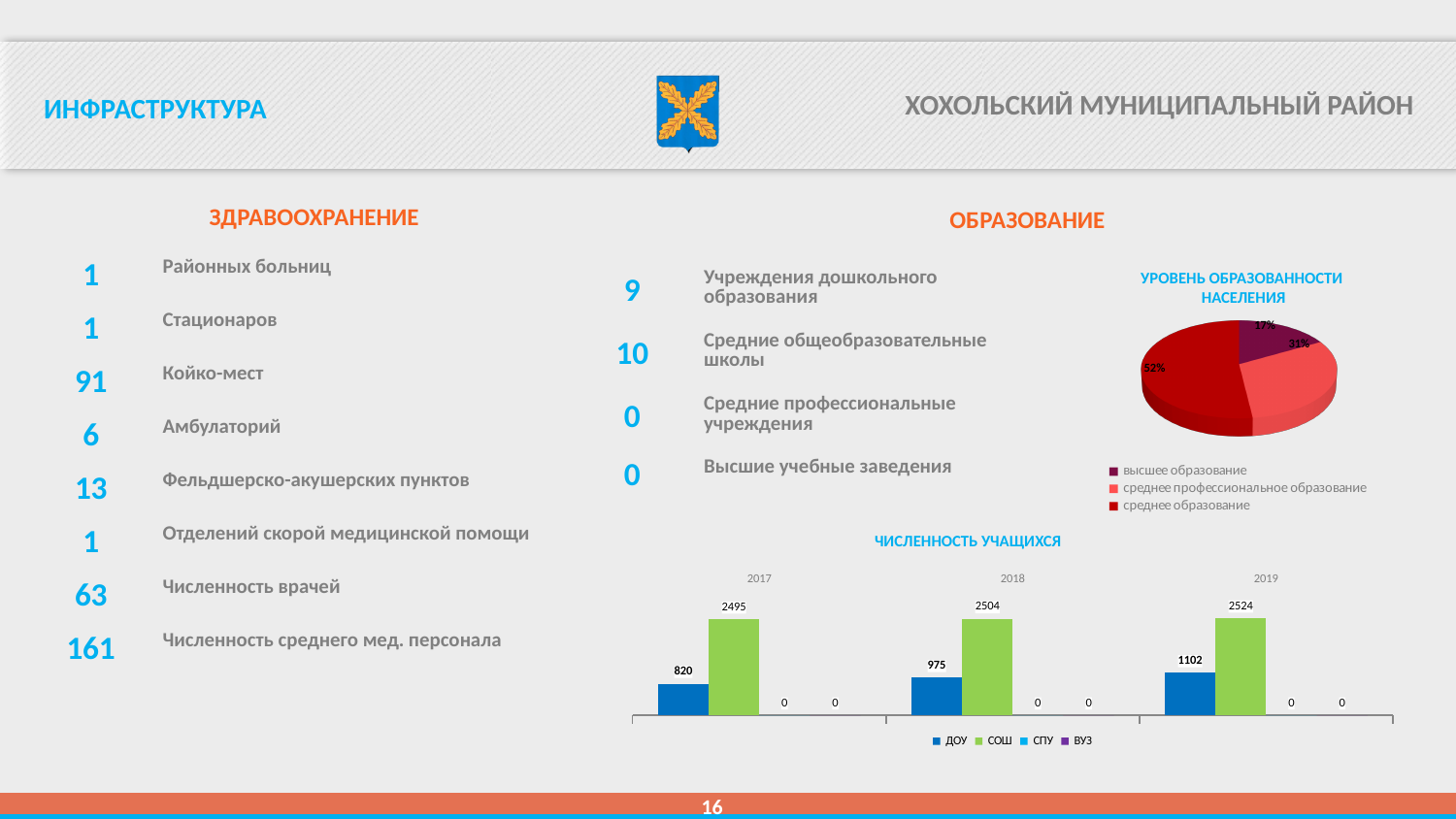
In the pie chart titled УРОВЕНЬ ОБРАЗОВАННОСТИ НАСЕЛЕНИЯ, what share is labelled for среднее профессиональное образование? 31% In the chart titled ЧИСЛЕННОСТЬ УЧАЩИХСЯ, which is larger in 2018: ДОУ or СОШ? СОШ In the chart titled ЧИСЛЕННОСТЬ УЧАЩИХСЯ, how many series does the legend list? 4 In the chart titled ЧИСЛЕННОСТЬ УЧАЩИХСЯ, what is the value for ДОУ in 2018? 975 In the chart titled ЧИСЛЕННОСТЬ УЧАЩИХСЯ, what is the value for СОШ in 2019? 2524 In the chart titled ЧИСЛЕННОСТЬ УЧАЩИХСЯ, what is the value for ДОУ in 2017? 820 In the pie chart titled УРОВЕНЬ ОБРАЗОВАННОСТИ НАСЕЛЕНИЯ, which category has the largest share? среднее образование In the chart titled ЧИСЛЕННОСТЬ УЧАЩИХСЯ, what is the difference between the СОШ value in 2019 and the СОШ value in 2017? 29 What kind of chart is the one titled ЧИСЛЕННОСТЬ УЧАЩИХСЯ? bar chart In the chart titled ЧИСЛЕННОСТЬ УЧАЩИХСЯ, which year has the highest value for ДОУ? 2019 In the chart titled ЧИСЛЕННОСТЬ УЧАЩИХСЯ, does the ДОУ value rise or fall from 2017 to 2019? rise In the chart titled ЧИСЛЕННОСТЬ УЧАЩИХСЯ, how many years are shown on the x axis? 3